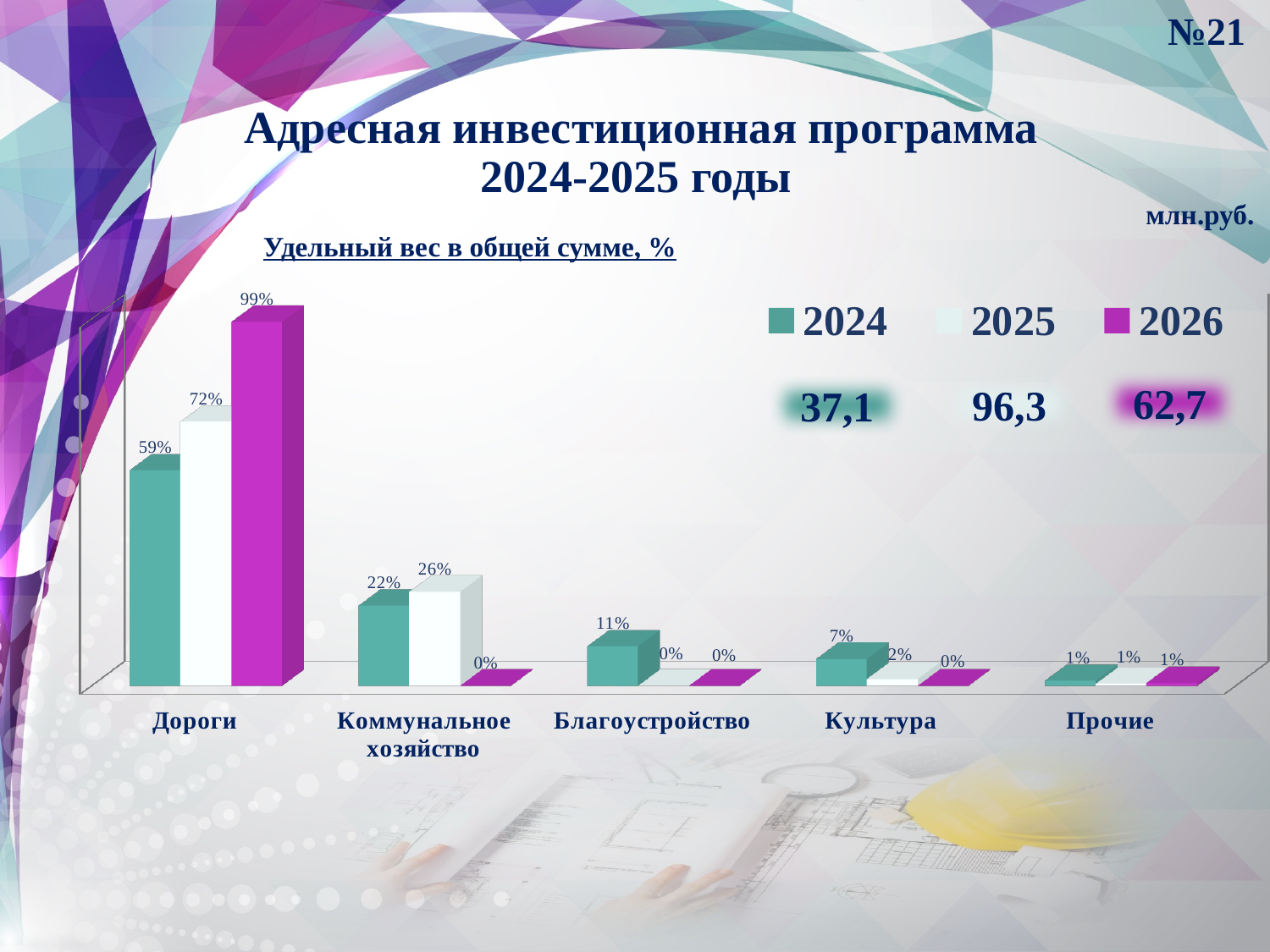
Which category has the highest value in the 2024 series? Дороги Which category has the lowest value in the 2024 series? Прочие What is the difference between the 2026 and 2024 values for Дороги? 40% Which is larger for Коммунальное хозяйство: the 2024 value or the 2025 value? 2025 What is the value for Культура in the 2025 series? 2% How many series does the chart legend list? 3 What total amount in млн.руб. is shown next to the 2025 legend entry? 96,3 What is the value for Благоустройство in the 2024 series? 11% What kind of chart is shown on the slide? Bar chart How many categories are shown on the x axis of the chart? 5 What is the value for Коммунальное хозяйство in the 2025 series? 26% What is the value for Дороги in the 2026 series? 99%